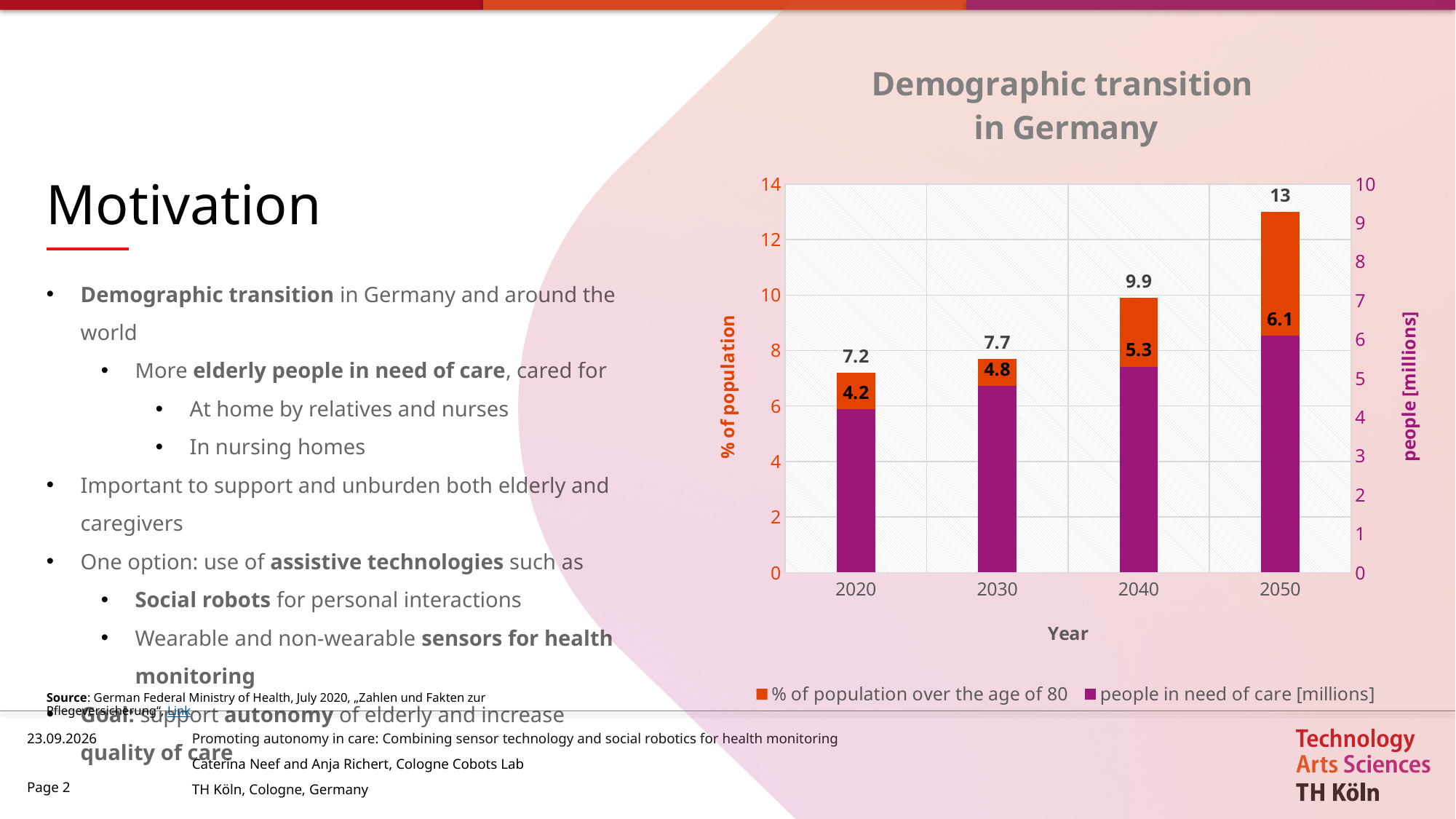
What is the value for '% of population over the age of 80' in 2050? 13 What is the difference between the '% of population over the age of 80' values for 2050 and 2020? 5.8 Which year has the lowest value for 'people in need of care [millions]'? 2020 How many years are shown on the x axis? 4 What is the value for 'people in need of care [millions]' in 2020? 4.2 What is the value for '% of population over the age of 80' in 2030? 7.7 How many series does the legend list? 2 What is the difference between the 'people in need of care [millions]' values for 2050 and 2030? 1.3 Which year has the highest value for '% of population over the age of 80'? 2050 Which is larger: the '% of population over the age of 80' value in 2040 or in 2030? 2040 Do the values for 'people in need of care [millions]' rise or fall from 2020 to 2050? rise What is the value for 'people in need of care [millions]' in 2040? 5.3